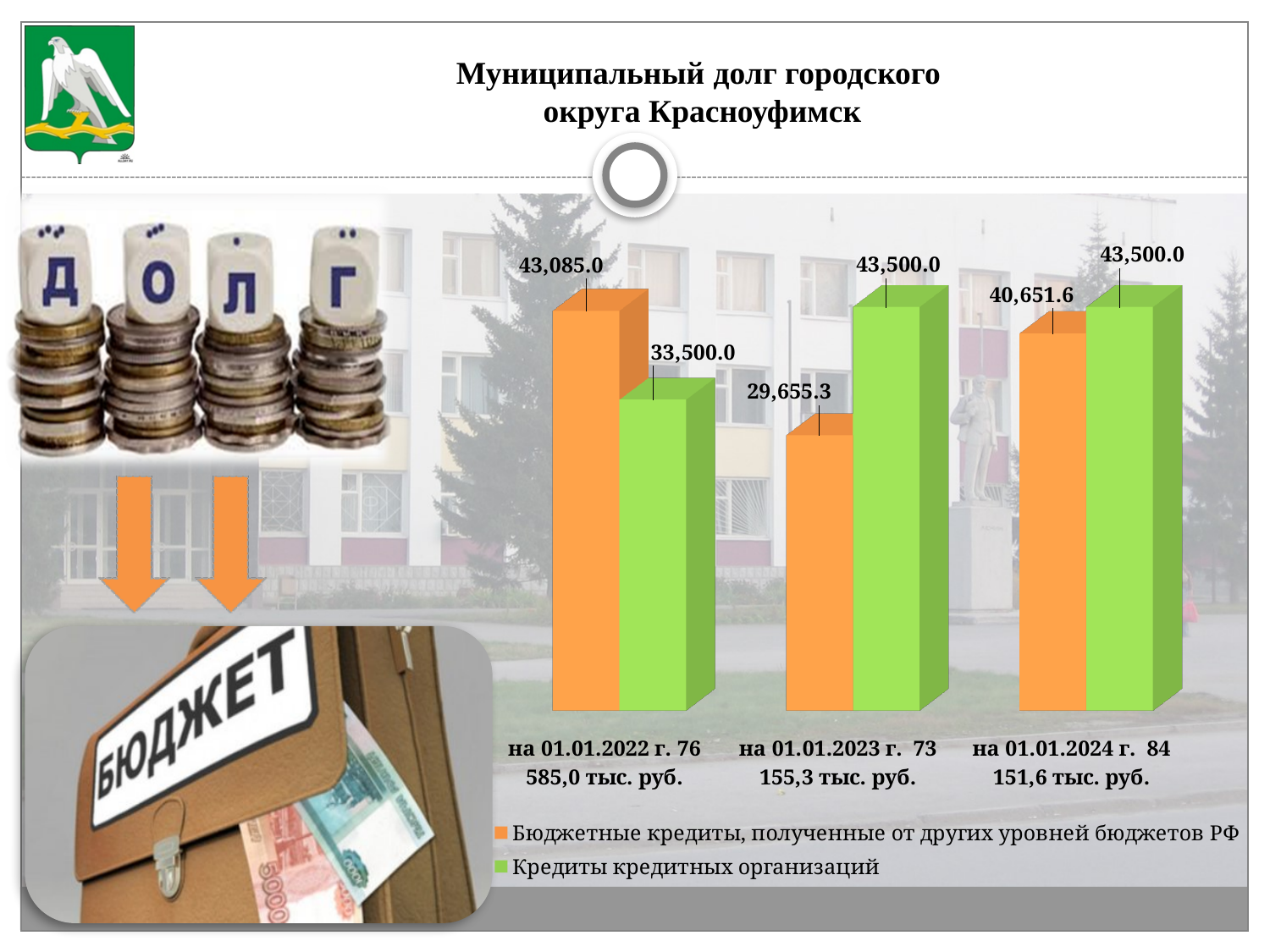
What is the value of budget credits (Бюджетные кредиты) as of 01.01.2022? 43,085.0 What is the value of credits from credit organisations (Кредиты кредитных организаций) as of 01.01.2023? 43,500.0 On which date is the value of budget credits (orange bars) the lowest? на 01.01.2023 г. How many series does the legend list? 2 What type of chart is shown on the slide? Bar chart What is the value of credits from credit organisations as of 01.01.2022? 33,500.0 How many dates (categories) are shown on the chart? 3 On which date is the value of budget credits (orange bars) the highest? на 01.01.2022 г. What is the difference between credits from credit organisations and budget credits as of 01.01.2023? 13,844.7 As of 01.01.2024, which is larger: budget credits or credits from credit organisations? Кредиты кредитных организаций What is the difference between budget credits and credits from credit organisations as of 01.01.2022? 9,585.0 What is the value of budget credits (Бюджетные кредиты) as of 01.01.2024? 40,651.6